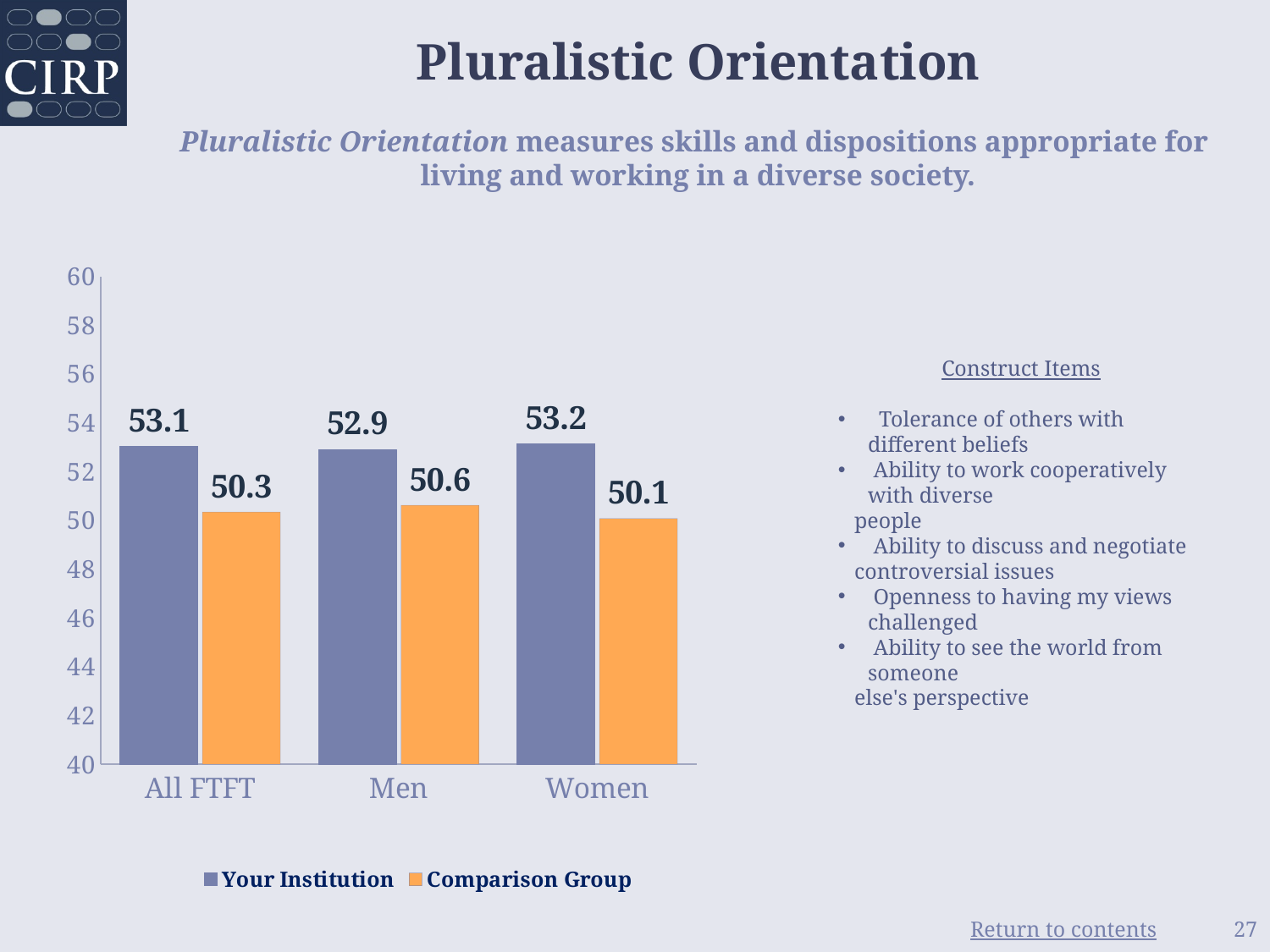
How many categories are shown on the x axis? 3 Which category has the highest Your Institution value? Women How many series does the legend list? 2 What is the Comparison Group value for Men? 50.6 For All FTFT, which is larger: Your Institution or Comparison Group? Your Institution Is the Comparison Group value for Women greater or less than 52? less What is the difference between the Your Institution and Comparison Group values for Men? 2.3 What is the Comparison Group value for Women? 50.1 What kind of chart is shown on the slide? bar chart Which category has the lowest Comparison Group value? Women What is the Your Institution value for Women? 53.2 What is the Your Institution value for All FTFT? 53.1